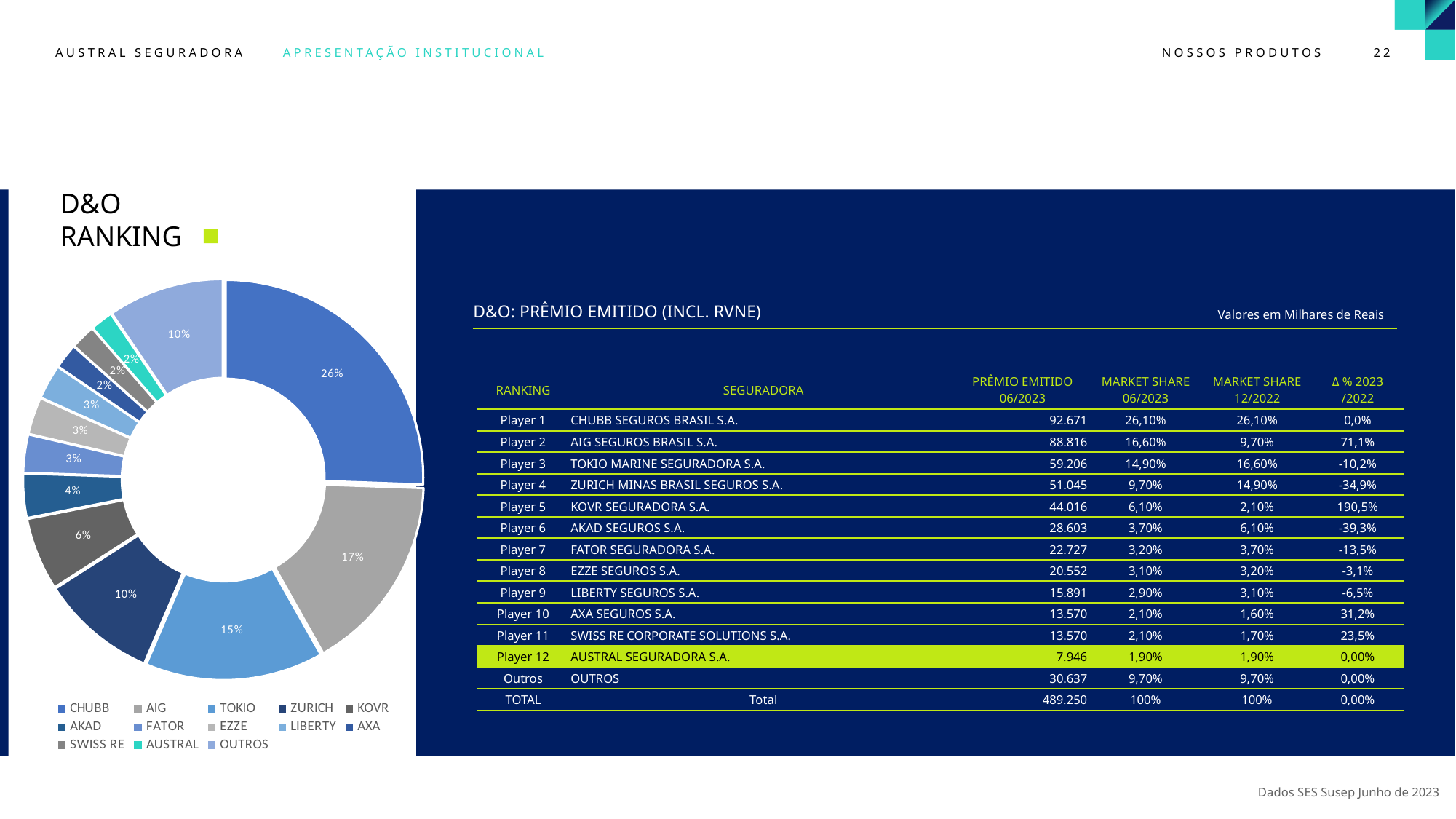
In the D&O RANKING chart, which slice is larger, TOKIO or ZURICH? TOKIO In the D&O RANKING chart, what share does AIG hold? 17% How many entries does the legend of the D&O RANKING chart list? 13 What kind of chart is shown on the left of the slide? Pie chart (donut) In the D&O RANKING chart, what share does AUSTRAL hold? 2% How many slices does the D&O RANKING chart have? 13 In the D&O RANKING chart, what is the difference in percentage points between CHUBB's share and AIG's share? 9 percentage points In the D&O RANKING chart, what share does CHUBB hold? 26% What is the title of the chart on the left of the slide? D&O RANKING In the D&O RANKING chart, what share does KOVR hold? 6% In the D&O RANKING chart, which insurer has the largest slice? CHUBB In the D&O RANKING chart, what share does TOKIO hold? 15%